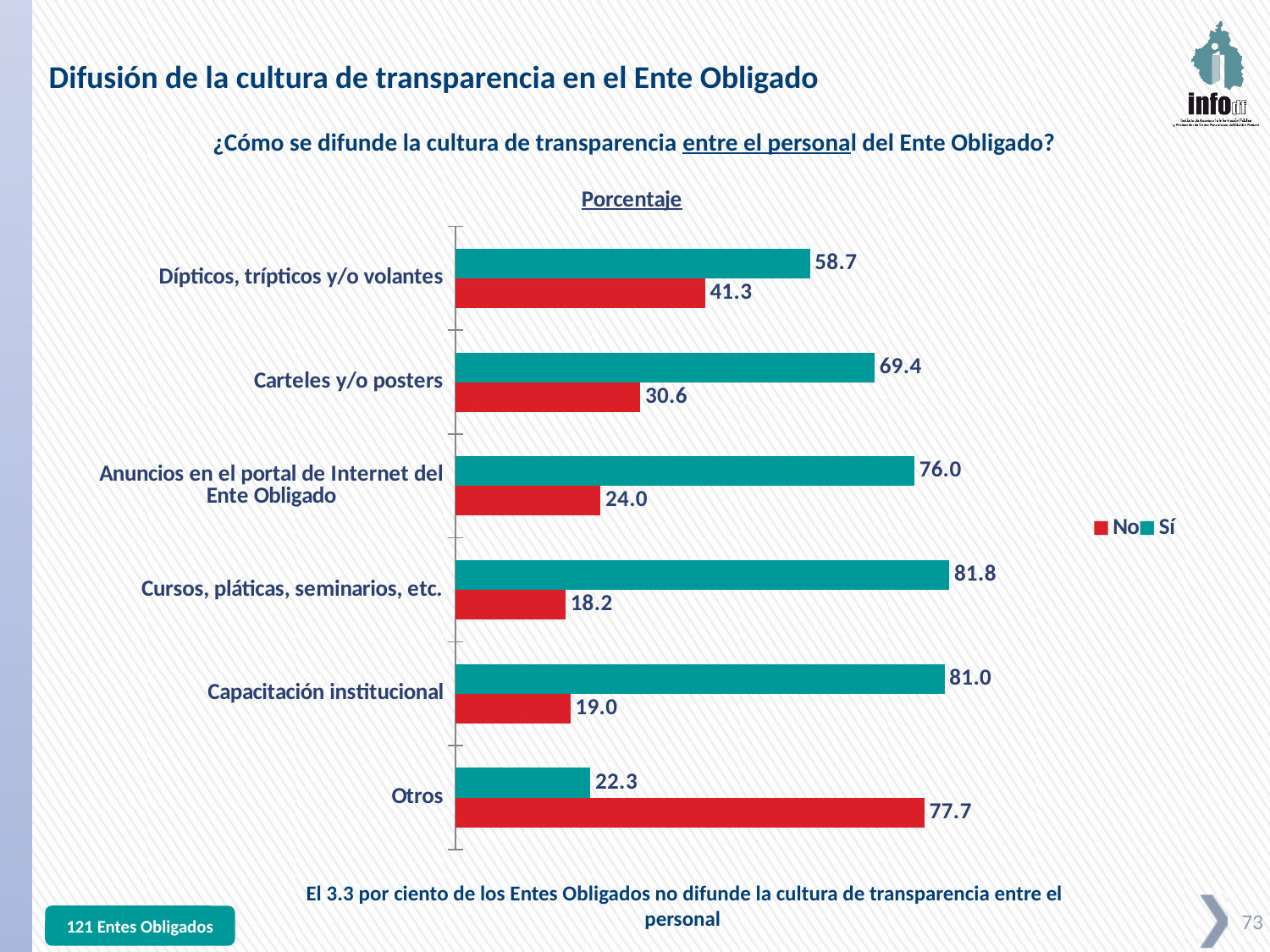
Which category has the highest 'Sí' value? Cursos, pláticas, seminarios, etc. What is the total of the 'Sí' and 'No' values for 'Capacitación institucional'? 100.0 What colour represents the 'No' series in the chart? Red What is the 'Sí' value for 'Cursos, pláticas, seminarios, etc.'? 81.8 Which category has the lowest 'No' value? Cursos, pláticas, seminarios, etc. What kind of chart is shown on the slide? Bar chart What is the 'Sí' value for 'Otros'? 22.3 What is the difference between the 'Sí' and 'No' values for 'Anuncios en el portal de Internet del Ente Obligado'? 52.0 What is the 'No' value for 'Carteles y/o posters'? 30.6 How many categories are shown on the chart? 6 How many series does the legend list? 2 Which is larger for 'Dípticos, trípticos y/o volantes': the 'Sí' value or the 'No' value? Sí